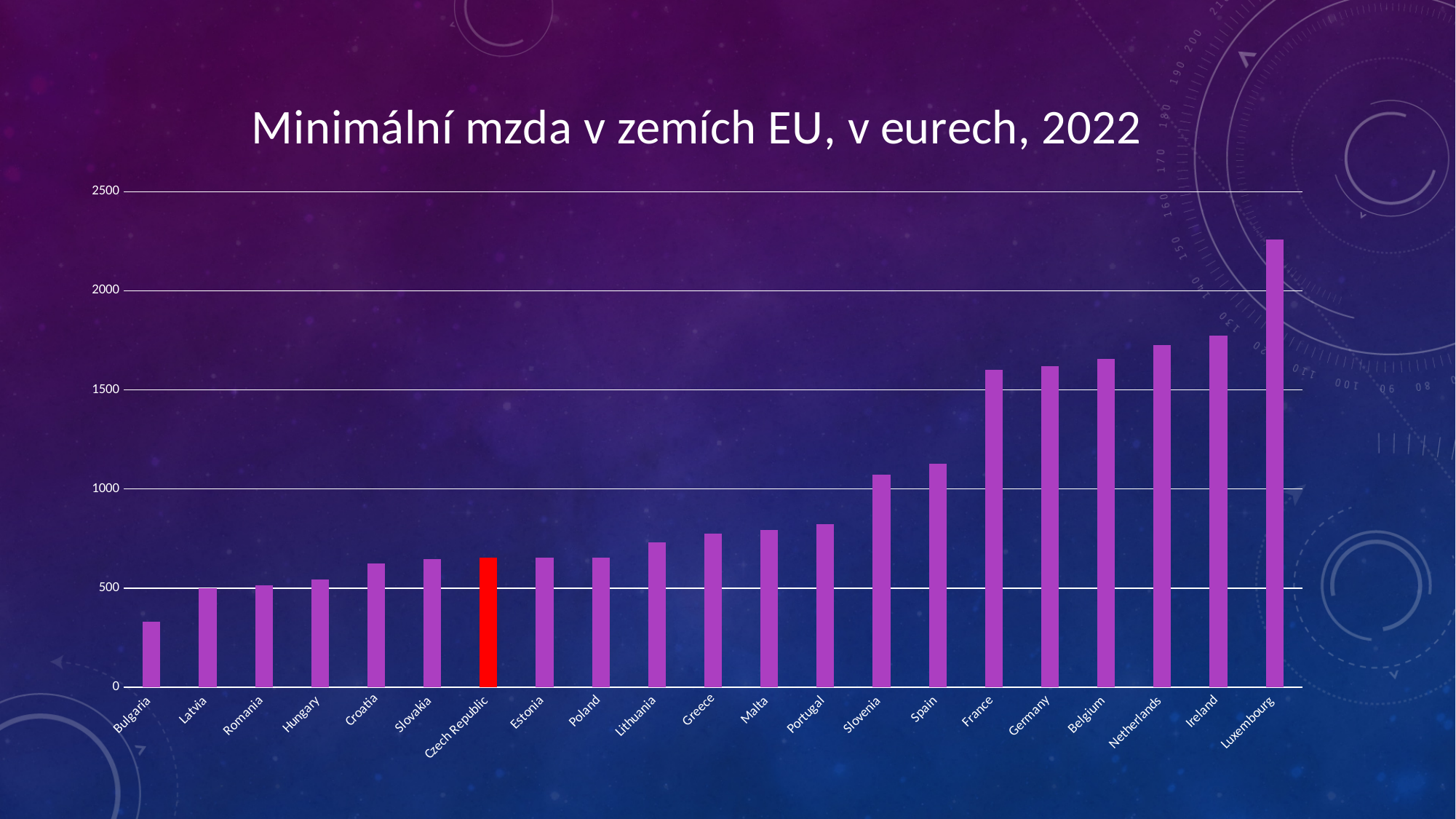
Is the value for Croatia greater or less than 500? greater Is the value for Luxembourg greater or less than 2000? greater Is the value for Bulgaria greater or less than 500? less What kind of chart is shown on the slide? bar chart How many countries are shown on the x axis of the chart? 21 Which country has the highest minimum wage in the chart? Luxembourg Do the values generally rise or fall from left to right along the x axis? rise Which has a higher minimum wage, Germany or Greece? Germany Which country has the lowest minimum wage in the chart? Bulgaria Which country's bar is highlighted in red? Czech Republic